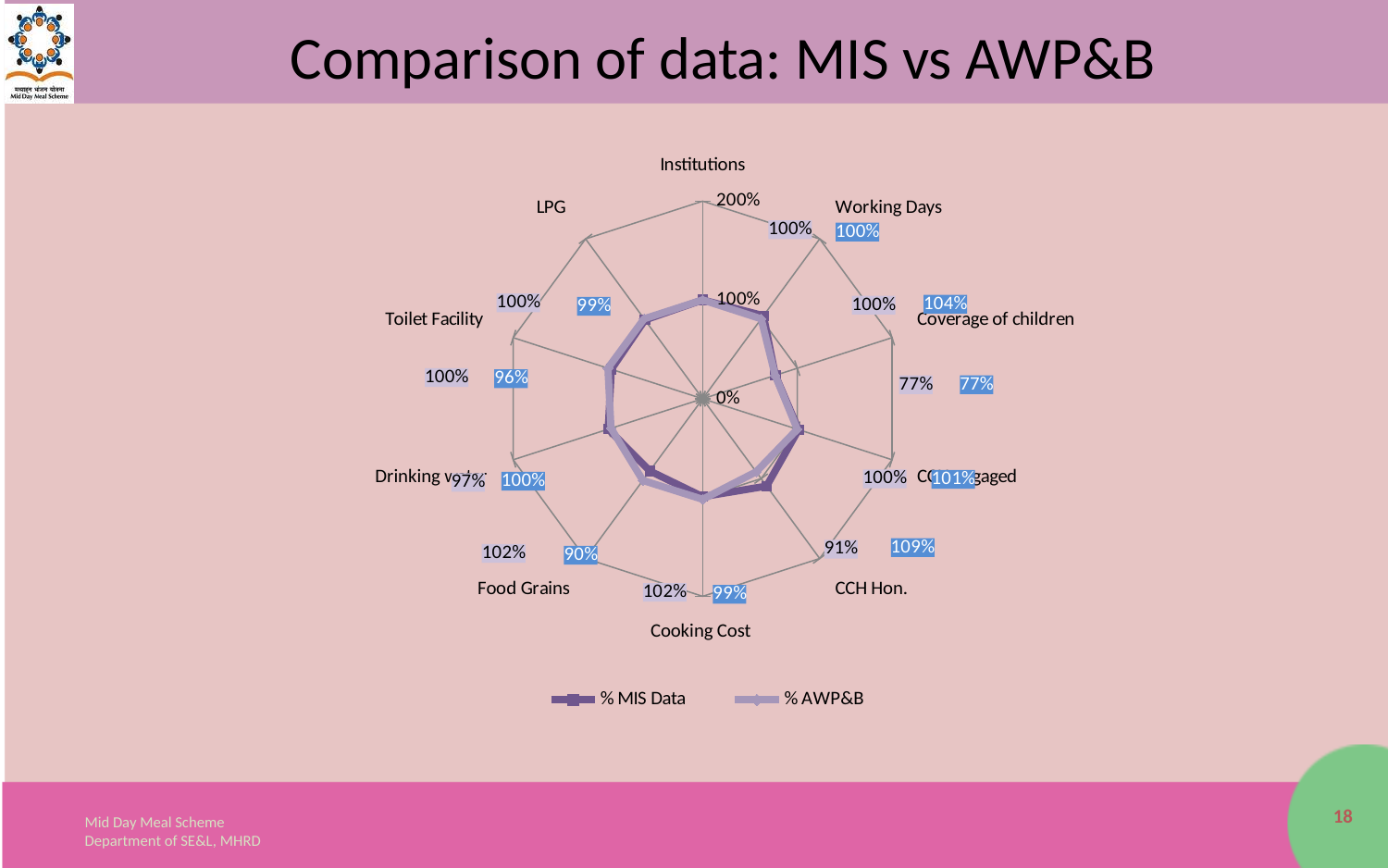
What is the difference between the % MIS Data value (109%) and the % AWP&B value (91%) for CCH Hon.? 18% What are the two series named in the chart legend? % MIS Data and % AWP&B What is the % MIS Data value for CCH Hon.? 109% What value is shown for Working Days for both series? 100% for % AWP&B and 104% for % MIS Data What is the title of the slide containing the chart? Comparison of data: MIS vs AWP&B What is the % AWP&B value for Food Grains? 102% What type of chart is shown on the slide? Radar chart What is the % MIS Data value for Food Grains? 90% What is the % MIS Data value for Toilet Facility? 96% How many series does the chart legend list? 2 For Food Grains, which series has the larger value, % MIS Data or % AWP&B? % AWP&B What is the maximum value shown on the chart's radial axis? 200%